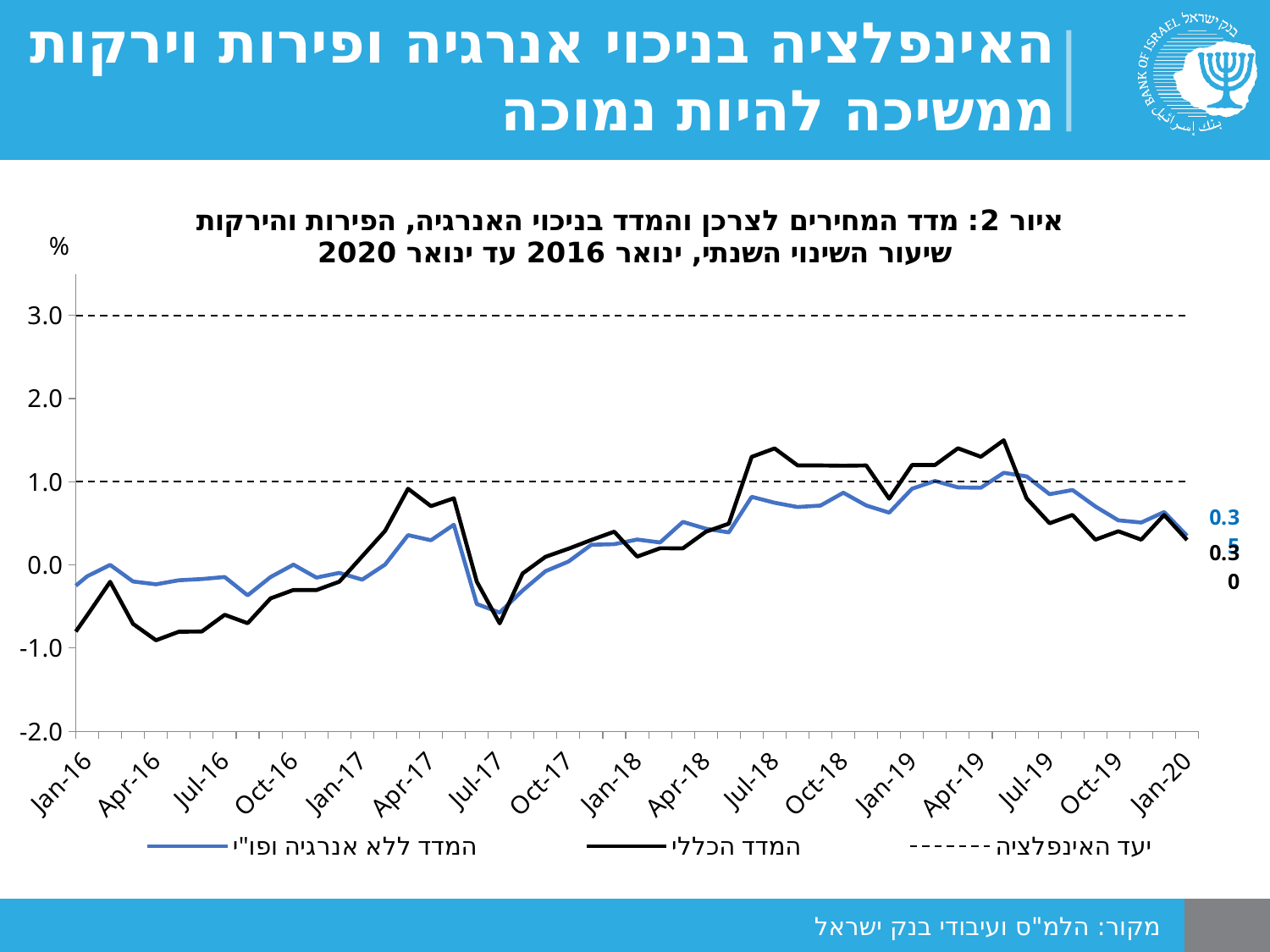
At what values are the two dashed inflation-target lines drawn? 1.0 and 3.0 Is the value of the general index (המדד הכללי) at Jan-16 greater or less than 0.0? less At Jan-16, which series is higher: the general index or the index excluding energy, fruits and vegetables? the index excluding energy, fruits and vegetables Does the index excluding energy, fruits and vegetables (המדד ללא אנרגיה ופו"י) rise or fall between Jul-19 and Oct-19? fall Is the value of the general index (המדד הכללי) at Apr-19 greater or less than 1.0? greater What kind of chart is shown on the slide? line chart At Apr-17, which series is higher: the general index or the index excluding energy, fruits and vegetables? the general index Does the general index (המדד הכללי) rise or fall between Jan-16 and Apr-17? rise Is the value of the general index (המדד הכללי) at Jul-17 greater or less than 0.0? less How many entries does the chart legend list? 3 What unit is shown on the vertical axis of the chart? %